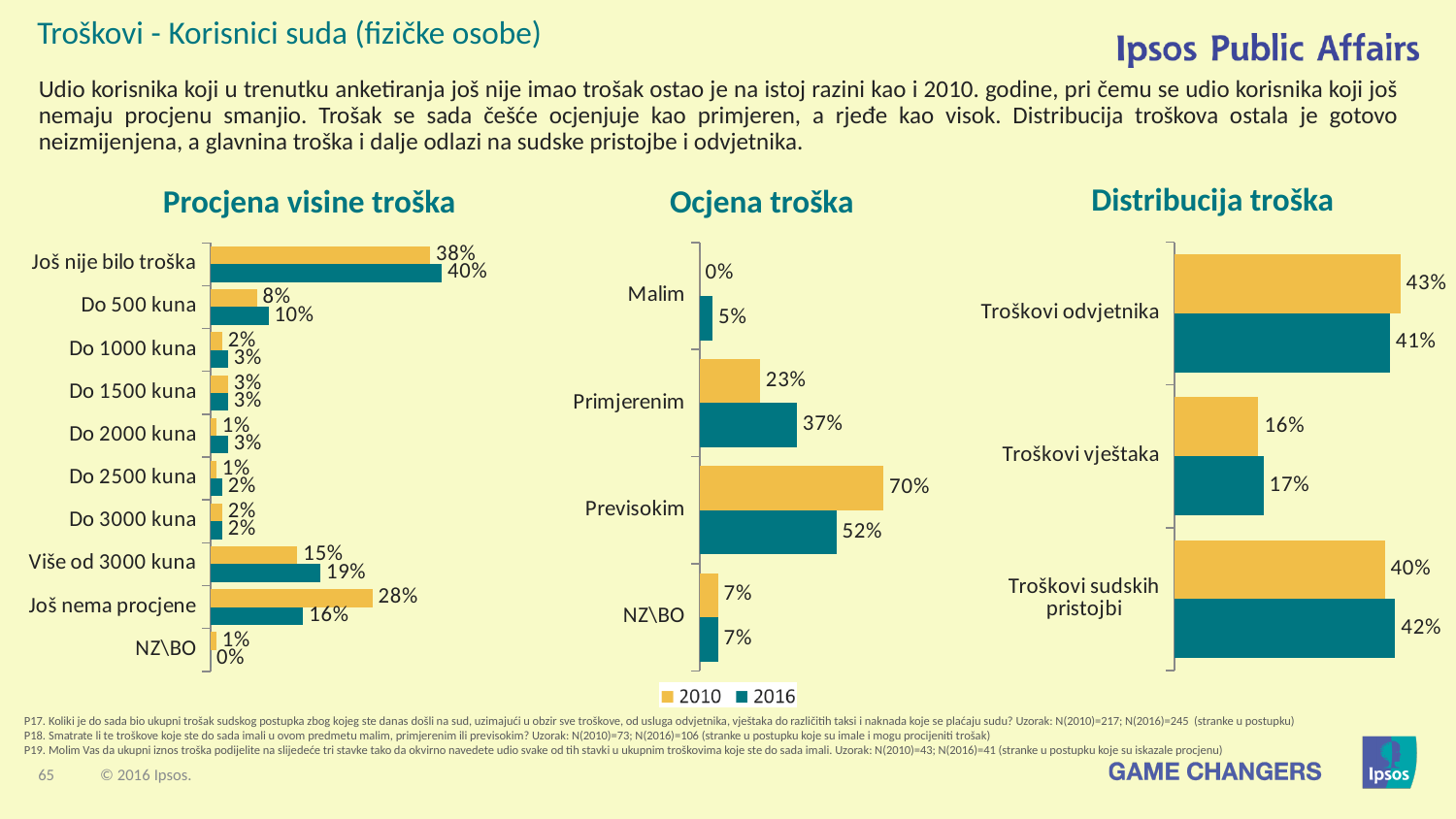
In the 'Distribucija troška' chart, which is larger for 2016: 'Troškovi odvjetnika' or 'Troškovi sudskih pristojbi'? Troškovi sudskih pristojbi In the 'Procjena visine troška' chart, what is the 2016 value for 'Još nije bilo troška'? 40% In the 'Distribucija troška' chart, what is the difference between the 2010 and 2016 values for 'Troškovi odvjetnika'? 2% In the 'Ocjena troška' chart, which category has the lowest 2010 value? Malim In the 'Procjena visine troška' chart, which category has the highest 2010 value? Još nije bilo troška How many series does the legend at the bottom of the slide list? 2 In the 'Procjena visine troška' chart, what is the 2010 value for 'Još nema procjene'? 28% In the 'Procjena visine troška' chart, how many categories are shown on the vertical axis? 10 What type of chart is 'Ocjena troška'? Bar chart In the 'Distribucija troška' chart, what is the 2010 value for 'Troškovi vještaka'? 16% In the 'Ocjena troška' chart, what is the 2016 value for 'Primjerenim'? 37% In the 'Ocjena troška' chart, what is the difference between the 2010 and 2016 values for 'Previsokim'? 18%